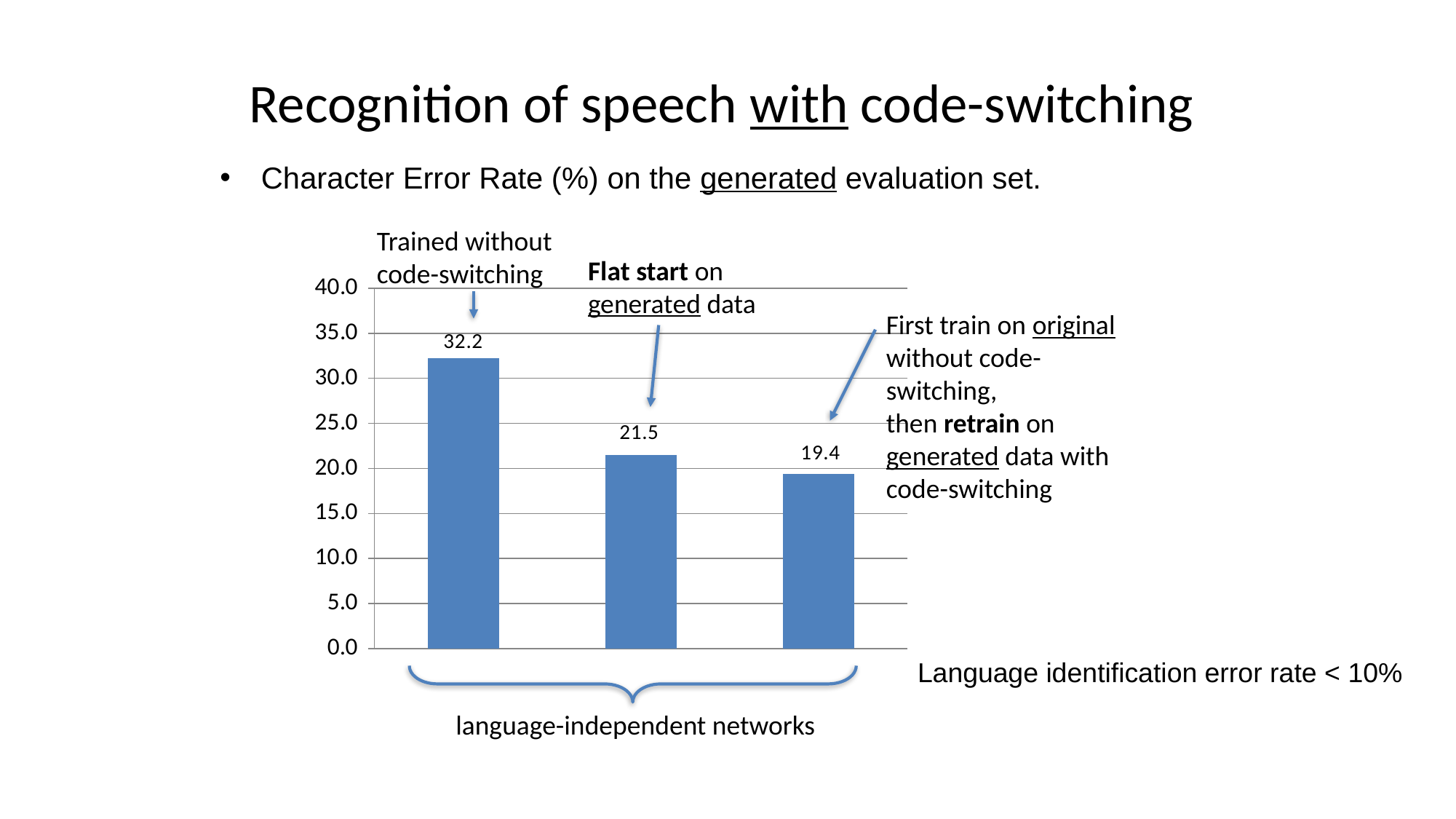
Which has a higher Character Error Rate: the flat start on generated data or the retrained network? Flat start on generated data What type of chart is shown on the slide? Bar chart What is the difference in Character Error Rate between the middle bar (21.5) and the rightmost bar (19.4)? 2.1 How many bars are plotted in the chart? 3 What is the maximum value shown on the chart's vertical axis? 40.0 What is the Character Error Rate for the middle bar, annotated 'Flat start on generated data'? 21.5 Which bar has the highest Character Error Rate? Trained without code-switching (leftmost bar) What is the difference in Character Error Rate between the leftmost bar (32.2) and the middle bar (21.5)? 10.7 What is the Character Error Rate for the leftmost bar, annotated 'Trained without code-switching'? 32.2 What is the Character Error Rate for the rightmost bar, the network first trained on original data and then retrained on generated data with code-switching? 19.4 Which bar has the lowest Character Error Rate? First train on original, then retrain on generated data with code-switching (rightmost bar) Do the Character Error Rate values rise or fall from left to right across the bars? Fall